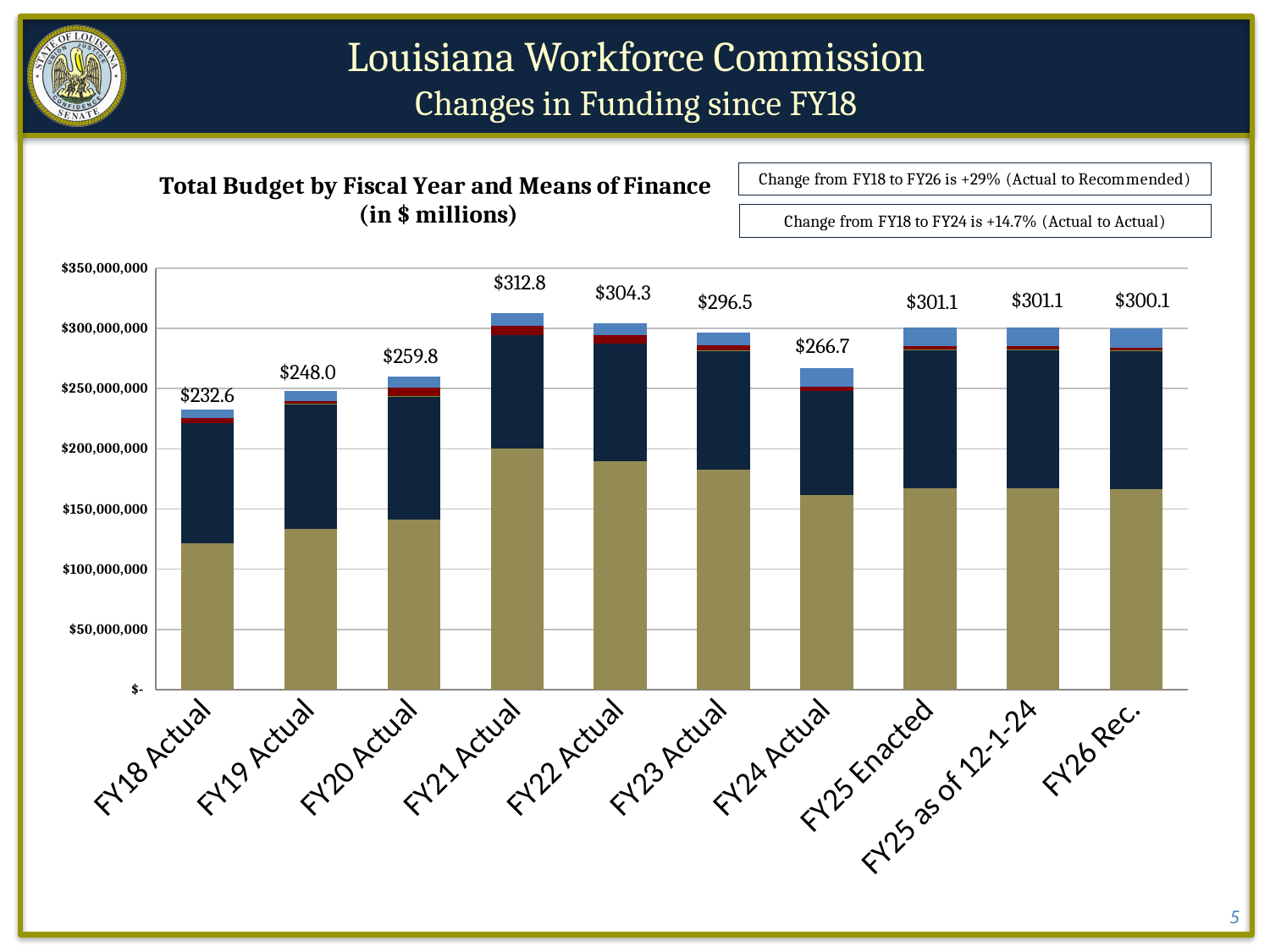
Is the total budget for FY24 Actual greater or less than $250,000,000? greater How many fiscal year categories are shown on the x axis? 10 Which is larger, the total budget for FY22 Actual or FY23 Actual? FY22 Actual What is the total budget shown for FY18 Actual? $232.6 What is the title of the chart? Total Budget by Fiscal Year and Means of Finance (in $ millions) Which fiscal year has the highest total budget? FY21 Actual Which fiscal year has the lowest total budget? FY18 Actual What is the total budget shown for FY21 Actual? $312.8 What is the difference between the total budget for FY21 Actual and FY18 Actual? $80.2 What is the difference between the total budget for FY24 Actual and FY23 Actual? $29.8 What is the total budget shown for FY26 Rec.? $300.1 What kind of chart is shown on the slide? Stacked bar chart